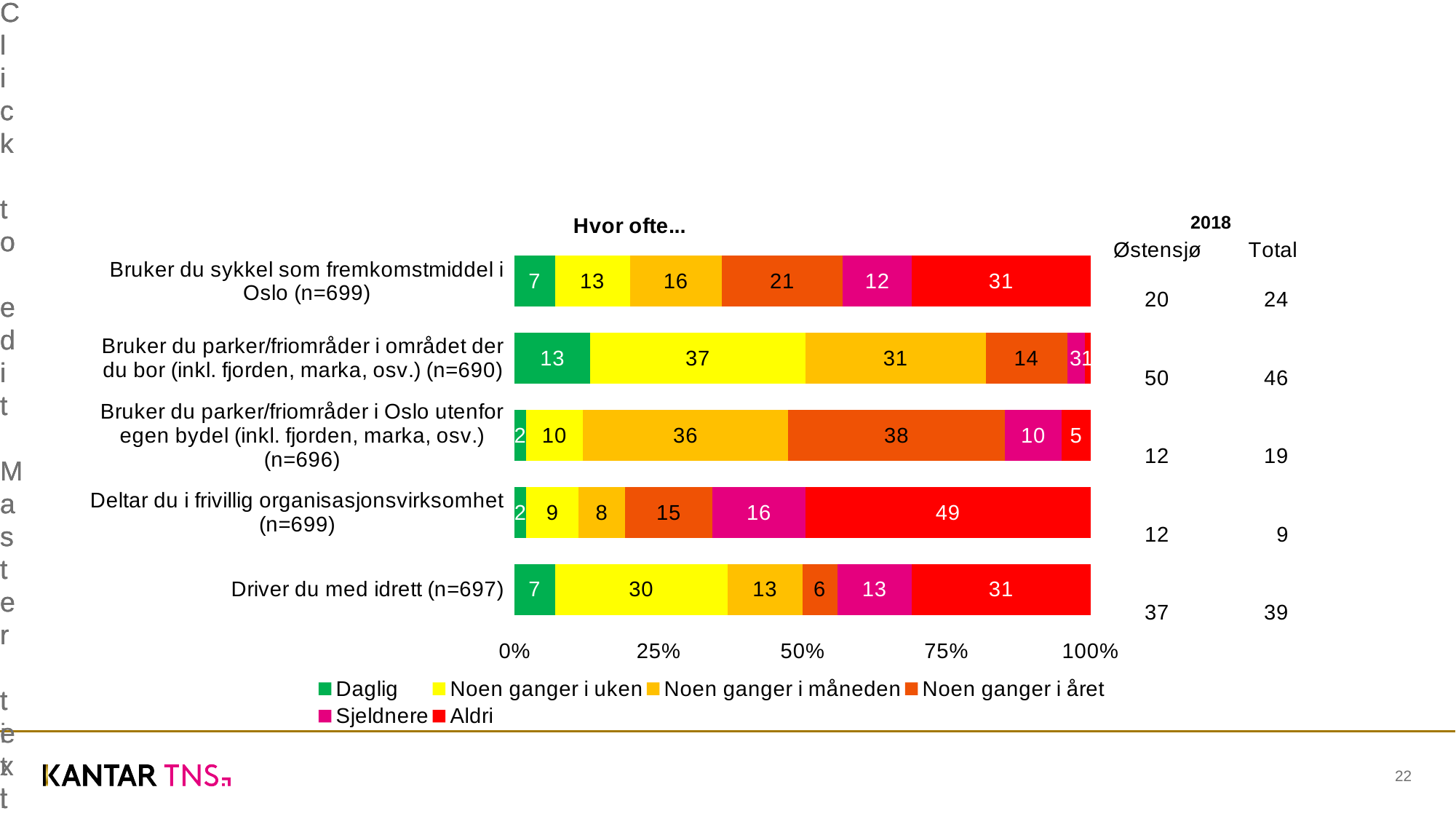
What is the 'Noen ganger i året' value for 'Bruker du parker/friområder i Oslo utenfor egen bydel (inkl. fjorden, marka, osv.) (n=696)'? 38 What is the 'Noen ganger i uken' value for 'Bruker du parker/friområder i området der du bor (inkl. fjorden, marka, osv.) (n=690)'? 37 Which is larger: the 'Noen ganger i måneden' value for 'Bruker du sykkel som fremkomstmiddel i Oslo (n=699)' or for 'Bruker du parker/friområder i Oslo utenfor egen bydel (inkl. fjorden, marka, osv.) (n=696)'? Bruker du parker/friområder i Oslo utenfor egen bydel (inkl. fjorden, marka, osv.) (n=696) Which category has the highest 'Daglig' value? Bruker du parker/friområder i området der du bor (inkl. fjorden, marka, osv.) (n=690) What is the 'Daglig' value for 'Driver du med idrett (n=697)'? 7 What is the difference between the 'Aldri' value for 'Deltar du i frivillig organisasjonsvirksomhet (n=699)' and the 'Aldri' value for 'Driver du med idrett (n=697)'? 18 What is the 'Aldri' value for 'Deltar du i frivillig organisasjonsvirksomhet (n=699)'? 49 What is the title of the chart? Hvor ofte... How many series does the legend list? 6 What kind of chart is shown on the slide? Stacked bar chart How many question categories are plotted in the chart? 5 Which category has the lowest 'Aldri' value? Bruker du parker/friområder i området der du bor (inkl. fjorden, marka, osv.) (n=690)